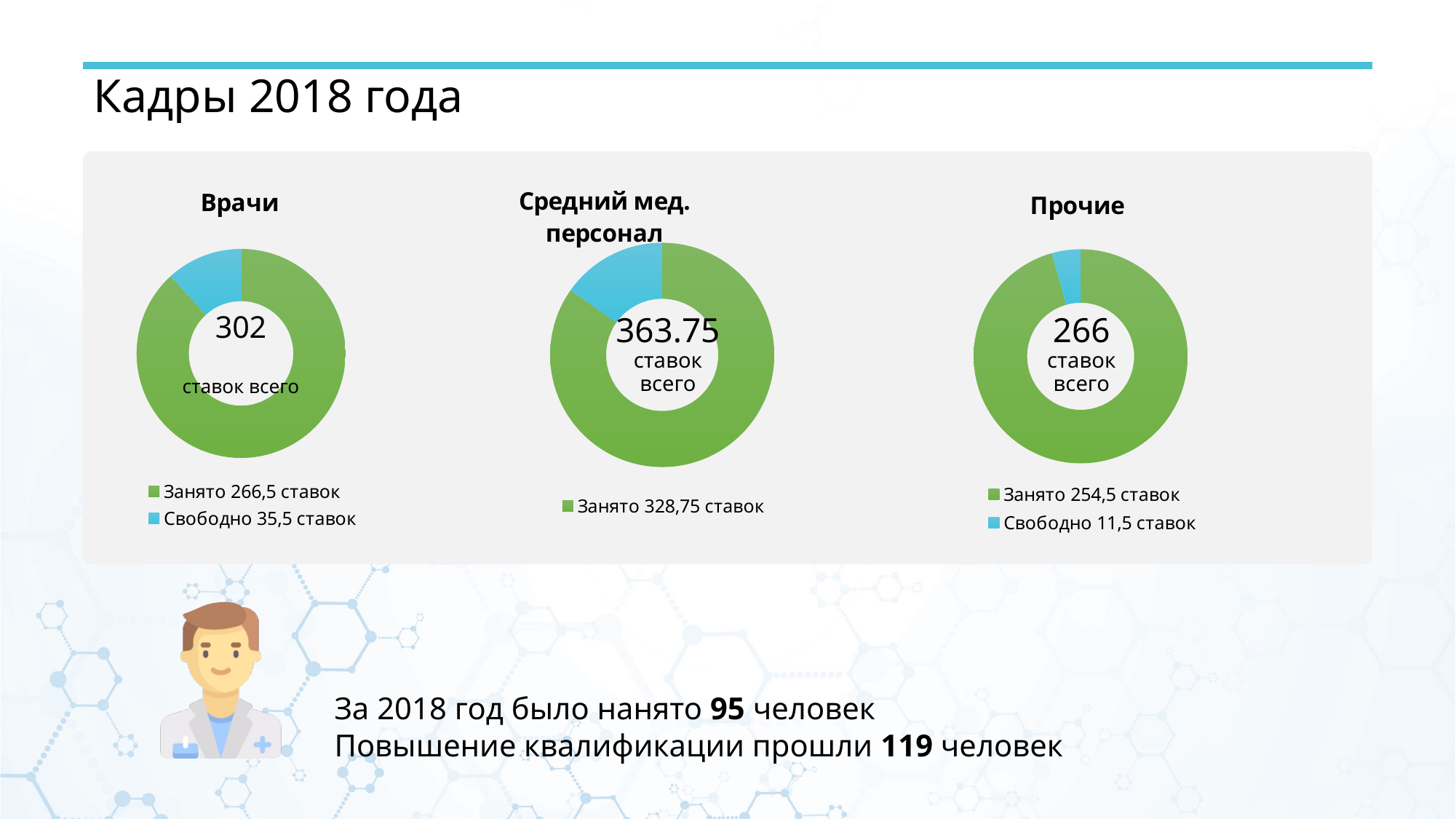
On the Средний мед. персонал chart, how many ставок are shown as Занято? 328,75 ставок What total number of ставок is printed in the centre of the Врачи chart? 302 On the Врачи chart, how many ставок are shown as Свободно? 35,5 ставок On the Врачи chart, which is larger: Занято or Свободно? Занято On the Врачи chart, how many ставок are shown as Занято? 266,5 ставок On the Прочие chart, how many ставок are shown as Свободно? 11,5 ставок What kind of chart is used for Врачи, Средний мед. персонал and Прочие? pie chart (donut) How many entries does the legend of the Врачи chart list? 2 On the Прочие chart, what is the difference between Занято and Свободно ставок? 243 ставок Which of the three charts has the largest total number of ставок in its centre? Средний мед. персонал What total number of ставок is printed in the centre of the Прочие chart? 266 What total number of ставок is printed in the centre of the Средний мед. персонал chart? 363.75